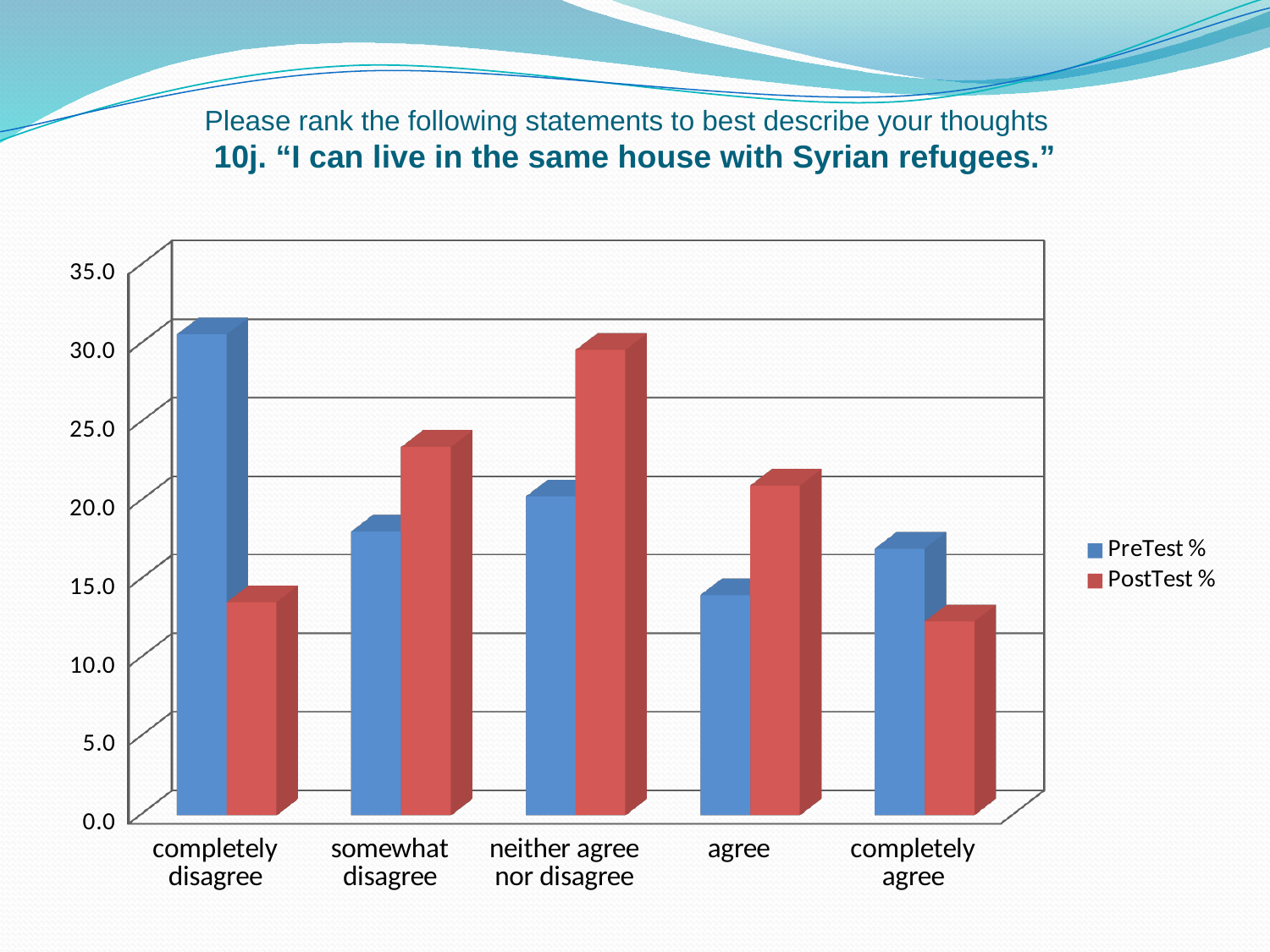
Which category has the highest PostTest % value? neither agree nor disagree For the agree category, which is larger: PreTest % or PostTest %? PostTest % Is the PostTest % value for neither agree nor disagree greater or less than 25.0? greater What kind of chart is shown on the slide? bar chart Which category has the highest PreTest % value? completely disagree Is the PostTest % value for completely disagree greater or less than 20.0? less What colour are the PostTest % bars? red How many series does the legend list? 2 Which category has the lowest PreTest % value? agree How many response categories are shown on the x axis? 5 For the completely disagree category, which is larger: PreTest % or PostTest %? PreTest % Is the PreTest % value for completely disagree greater or less than 25.0? greater